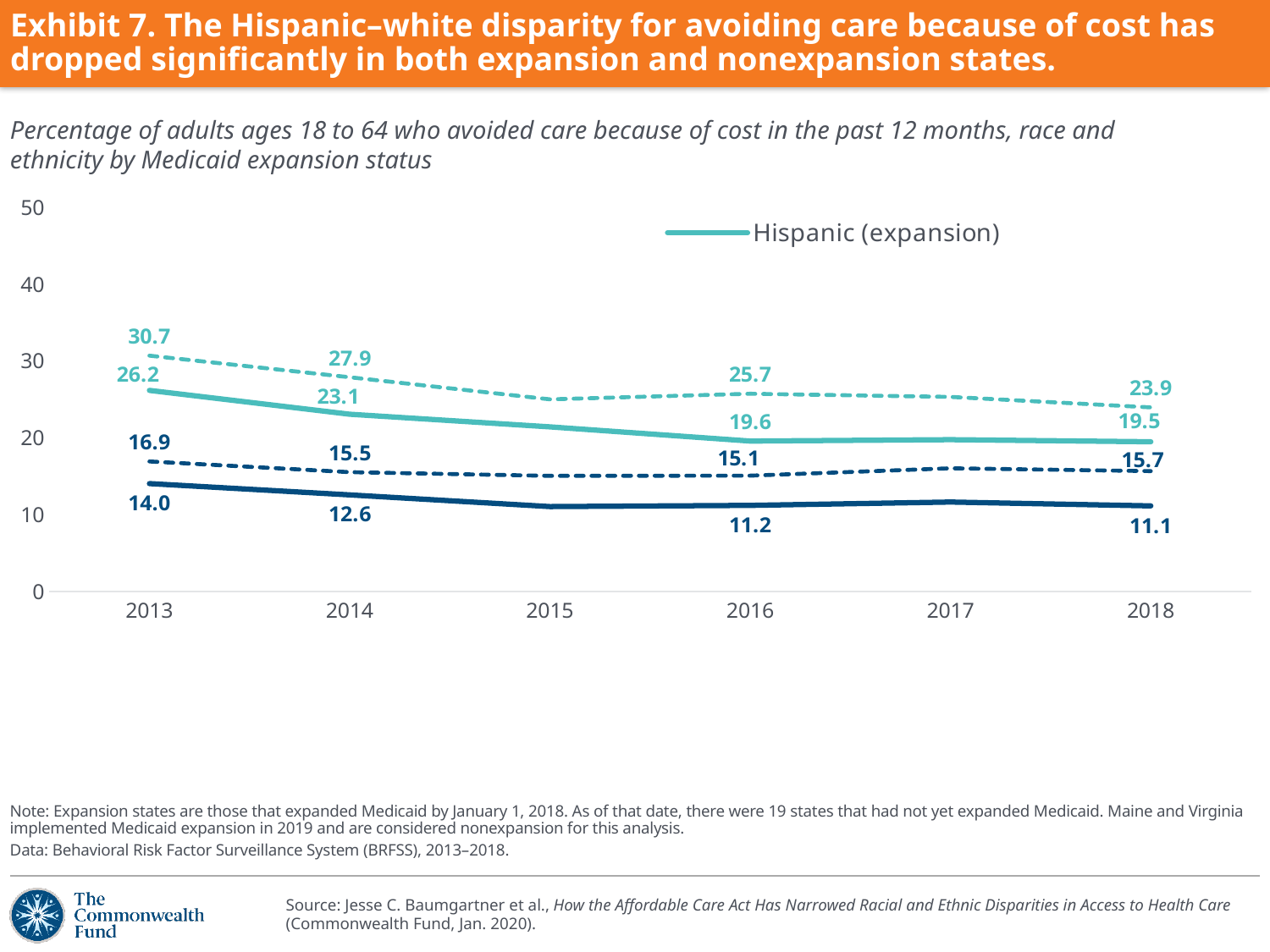
Does the Hispanic (expansion) line rise or fall from 2013 to 2018? Fall What type of chart is shown on the slide? Line chart What is the value for Hispanic (expansion) in 2014? 23.1 What is the value for Hispanic (expansion) in 2016? 19.6 Which is larger for Hispanic (expansion): the 2013 value or the 2014 value? 2013 Which series is named in the chart legend? Hispanic (expansion) Is the value for Hispanic (expansion) in 2015 greater or less than 30? less What is the value for Hispanic (expansion) in 2013? 26.2 What is the value for Hispanic (expansion) in 2018? 19.5 What is the difference between the Hispanic (expansion) values in 2013 and 2018? 6.7 How many years are shown on the x axis? 6 In which year is the Hispanic (expansion) value highest? 2013